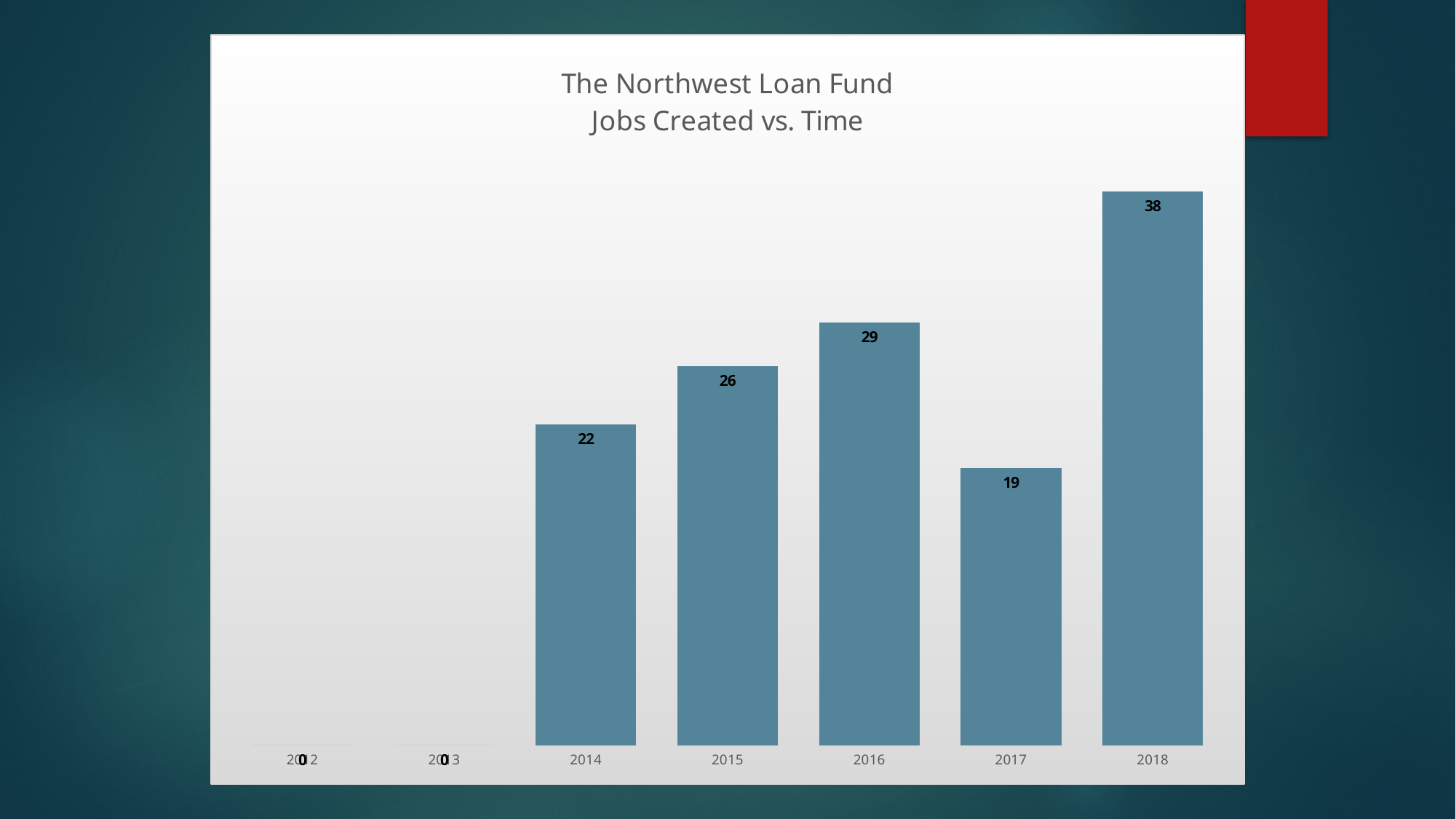
What is the value shown for 2017? 19 What is the value shown for 2014? 22 Which year has the highest number of jobs created? 2018 How many jobs were created in 2018? 38 What is the value shown for 2016? 29 What is the title of the chart? The Northwest Loan Fund Jobs Created vs. Time What kind of chart is shown on the slide? bar chart Among the years with a visible bar, which year has the lowest value? 2017 Do the values rise or fall from 2014 to 2016? rise Which is larger, the value for 2015 or the value for 2016? 2016 How many years are shown on the x axis? 7 What is the difference between the values for 2018 and 2017? 19